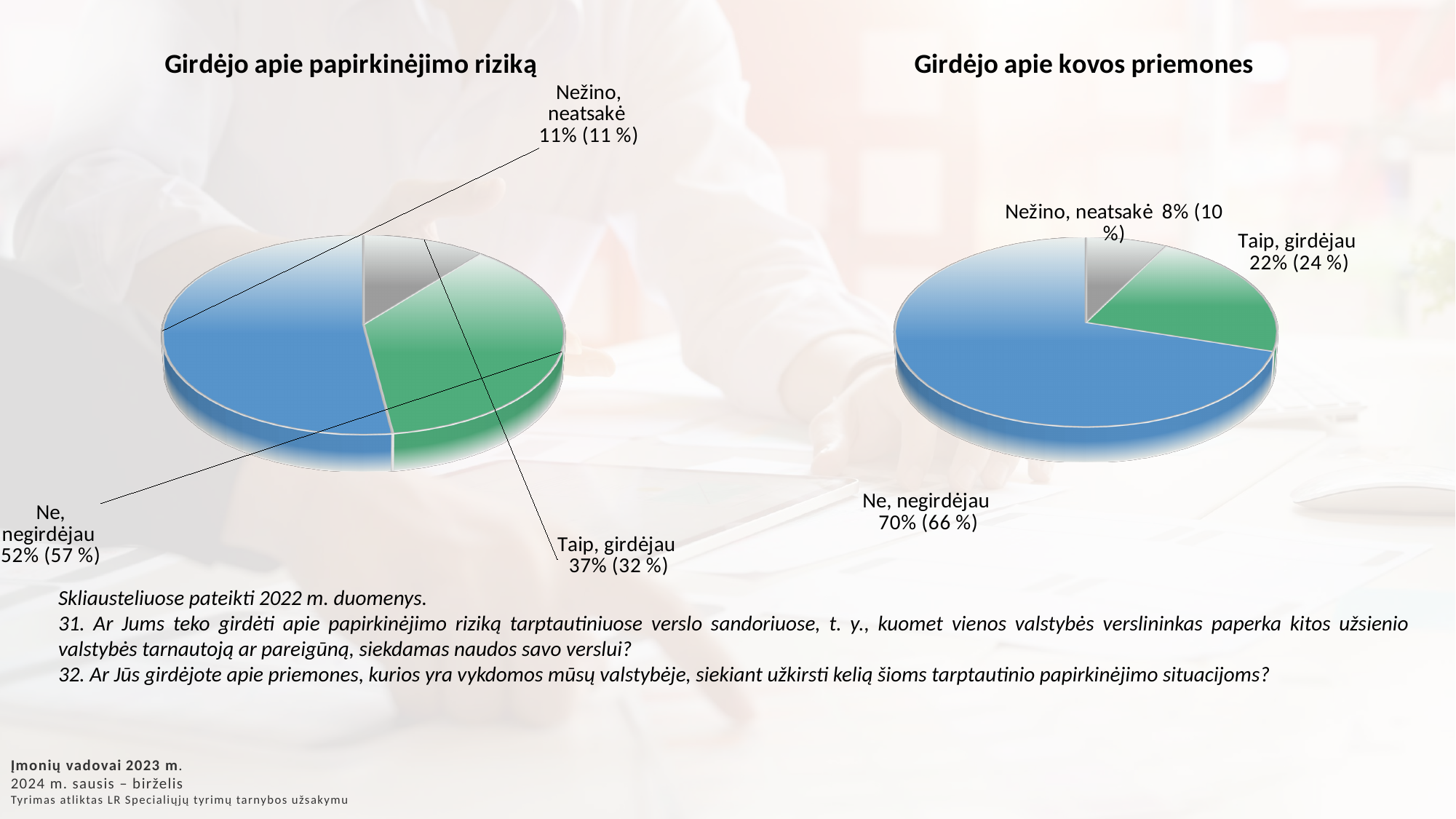
In the chart 'Girdėjo apie papirkinėjimo riziką', what is the share for 'Ne, negirdėjau'? 52% What type of chart is 'Girdėjo apie papirkinėjimo riziką'? Pie chart In the chart 'Girdėjo apie kovos priemones', what is the share for 'Ne, negirdėjau'? 70% In the chart 'Girdėjo apie kovos priemones', what is the share for 'Taip, girdėjau'? 22% In the chart 'Girdėjo apie kovos priemones', what 2022 value is shown in parentheses for 'Ne, negirdėjau'? 66 % In the chart 'Girdėjo apie papirkinėjimo riziką', which category has the largest slice? Ne, negirdėjau In the chart 'Girdėjo apie papirkinėjimo riziką', what 2022 value is shown in parentheses for 'Nežino, neatsakė'? 11 % In the chart 'Girdėjo apie kovos priemones', which category has the smallest slice? Nežino, neatsakė In the chart 'Girdėjo apie papirkinėjimo riziką', what is the difference between 'Ne, negirdėjau' and 'Taip, girdėjau'? 15% Which is larger: 'Taip, girdėjau' in the chart 'Girdėjo apie papirkinėjimo riziką' or 'Taip, girdėjau' in the chart 'Girdėjo apie kovos priemones'? Girdėjo apie papirkinėjimo riziką In the chart 'Girdėjo apie papirkinėjimo riziką', what is the share for 'Taip, girdėjau'? 37% How many slices does the chart 'Girdėjo apie kovos priemones' have? 3